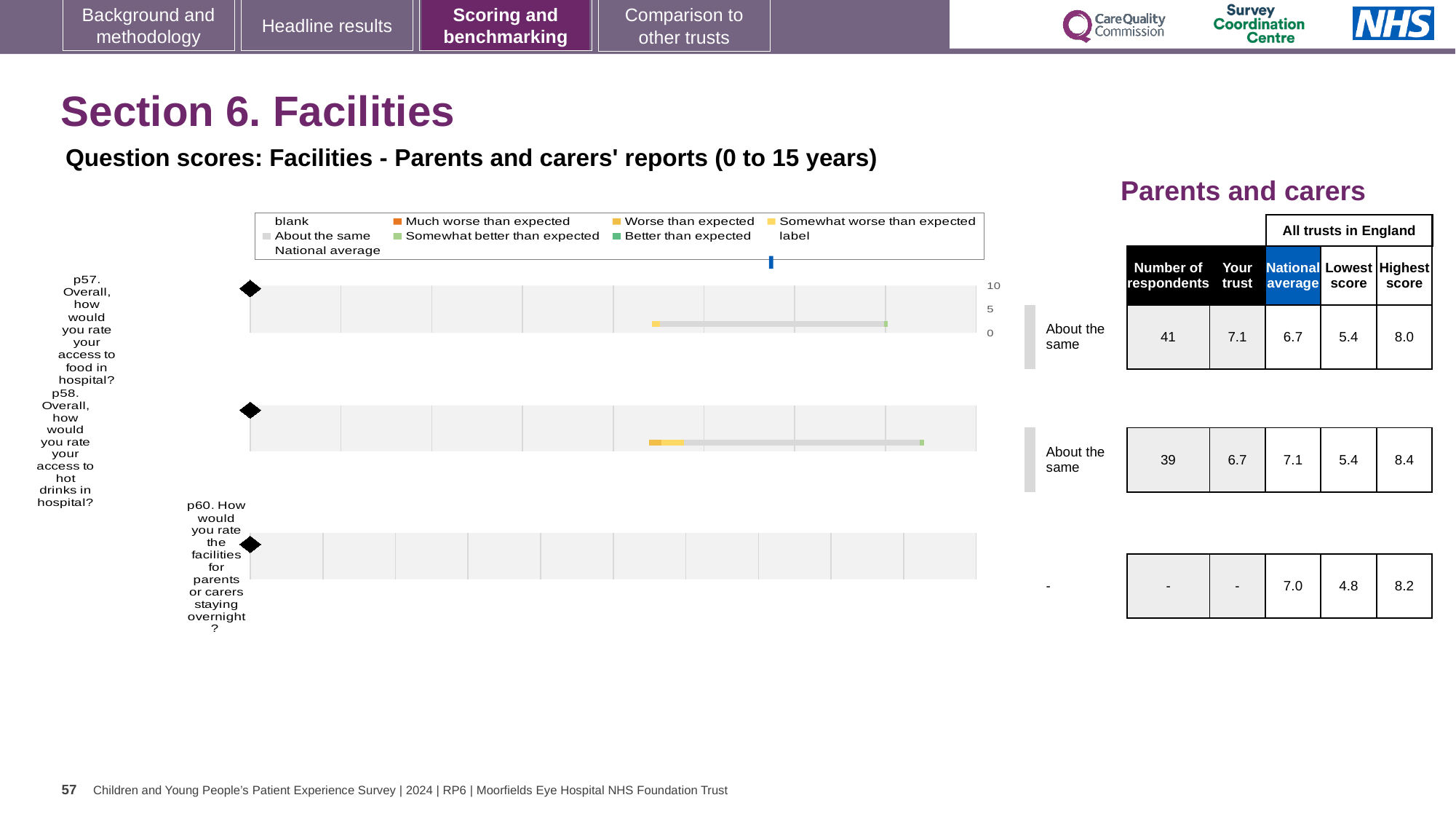
What is the difference between the 'Your trust' score and the national average for p57? 0.4 How many questions (p57, p58, p60) are plotted on the slide? 3 What is the highest score across all trusts in England for p60 (facilities for parents or carers staying overnight)? 8.2 How many respondents answered p57 (access to food in hospital)? 41 What is the lowest score across all trusts in England for p60 (facilities for parents or carers staying overnight)? 4.8 What is the 'Your trust' score for p57 (access to food in hospital)? 7.1 What benchmark category is shown for p57 (access to food in hospital)? About the same For p57, which is higher: the 'Your trust' score or the national average? Your trust What is the national average score for p58 (access to hot drinks in hospital)? 7.1 Which question has the highest 'Highest score' value among all trusts in England? p58 What is the difference between the highest score and the lowest score for p58 (access to hot drinks)? 3.0 What kind of chart is used to show the question scores on this slide? bar chart